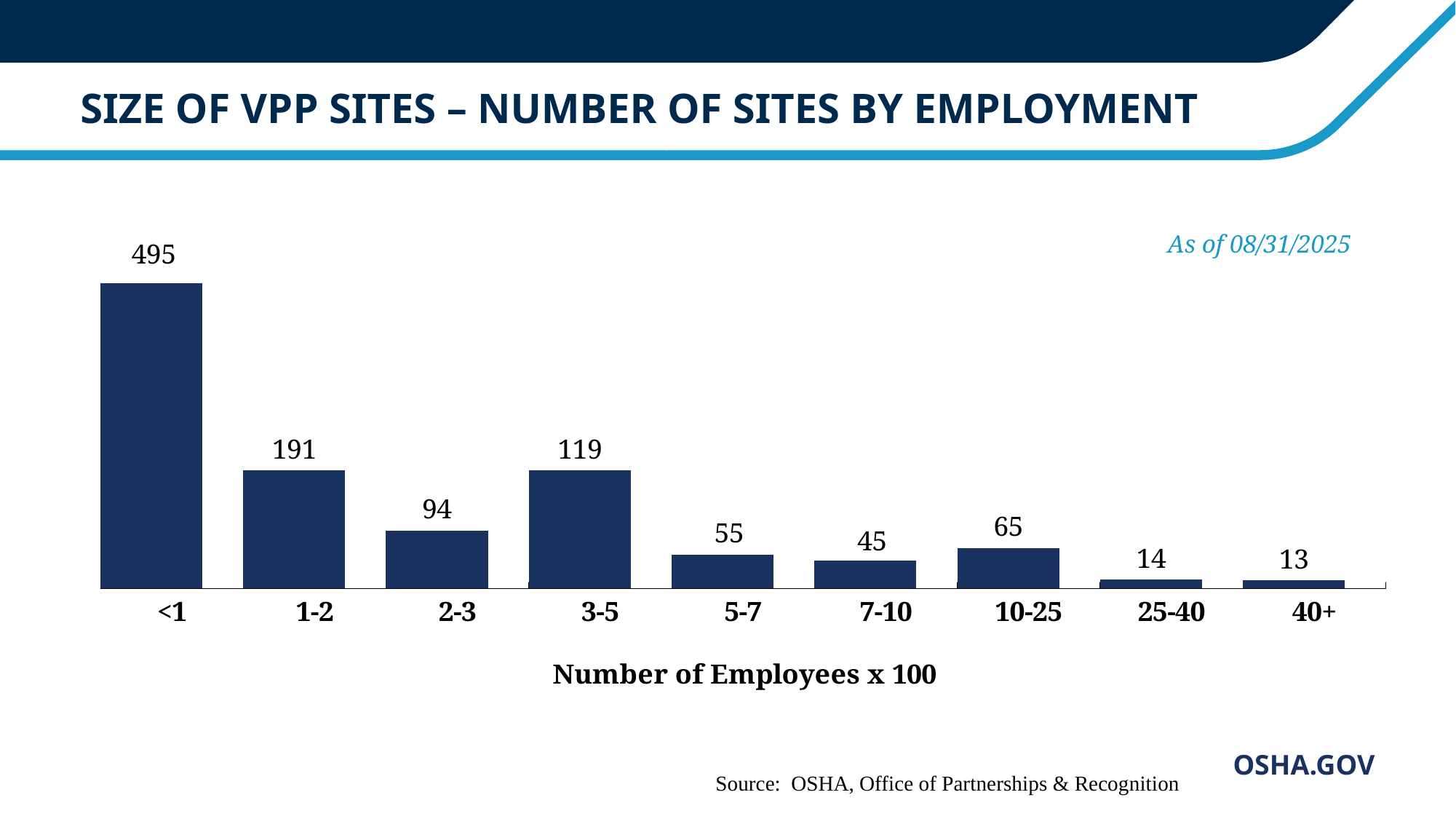
Which employment category has the highest number of sites? <1 As of what date is the data on the chart reported? 08/31/2025 What is the difference between the number of sites in the "1-2" category and the "2-3" category? 97 What kind of chart is shown on the slide? Bar chart What is the number of sites in the "3-5" employment category? 119 Which employment category has the lowest number of sites? 40+ What is the number of sites in the "10-25" employment category? 65 What is the difference between the number of sites in the "<1" category and the "1-2" category? 304 What is the label of the x axis? Number of Employees x 100 How many employment categories are shown on the chart? 9 How many VPP sites have fewer than 100 employees (the "<1" category)? 495 Which has more sites, the "5-7" category or the "7-10" category? 5-7